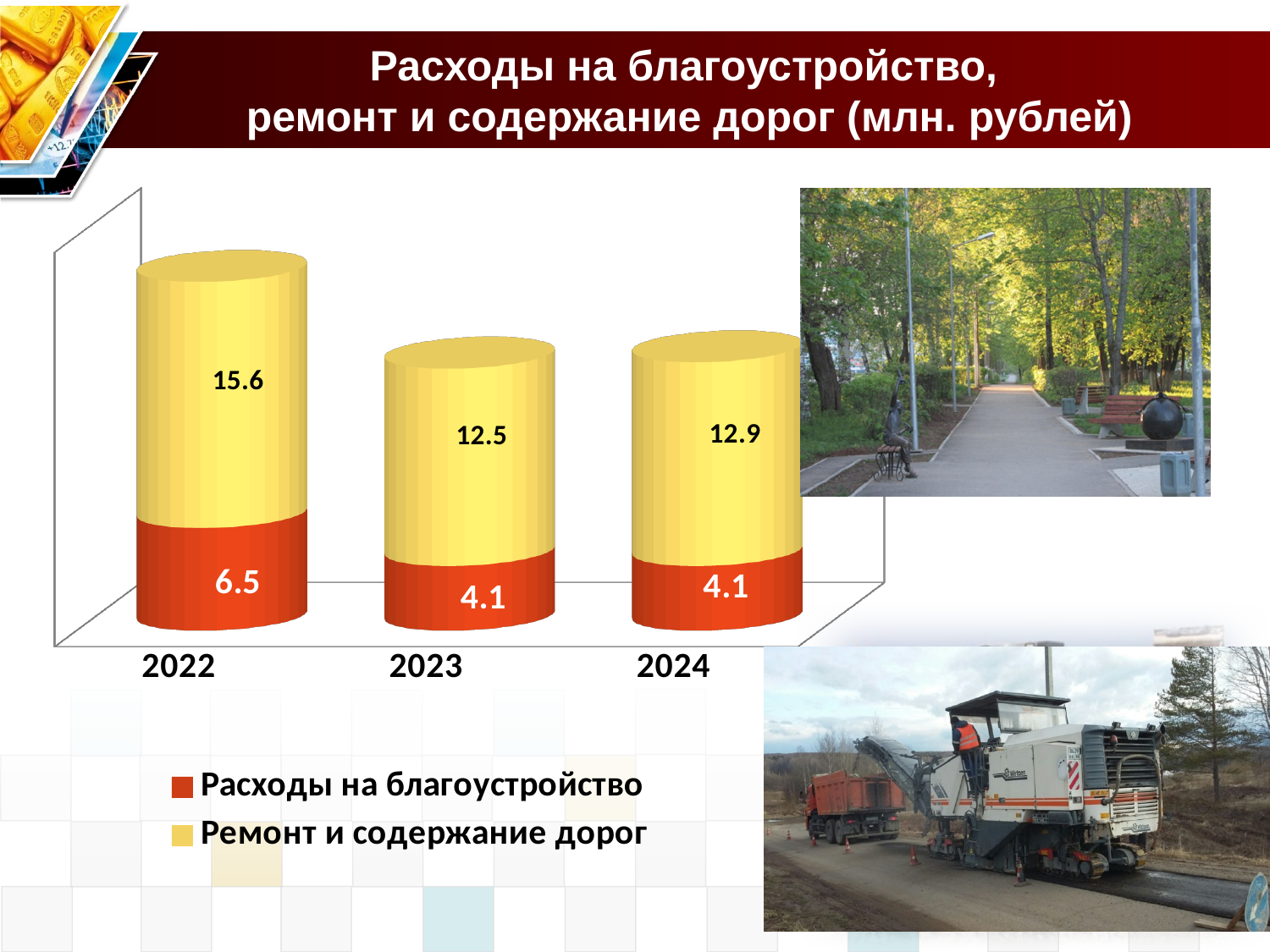
Which colour represents Расходы на благоустройство in the legend? Red What is the value for Расходы на благоустройство in 2023? 4.1 How many series does the legend list? 2 What is the value for Ремонт и содержание дорог in 2022? 15.6 What is the difference between Ремонт и содержание дорог in 2022 and 2023? 3.1 Which is larger: Расходы на благоустройство in 2022 or in 2024? 2022 What is the total of the stacked bar for 2022? 22.1 In which year is Ремонт и содержание дорог lowest? 2023 What is the value for Ремонт и содержание дорог in 2024? 12.9 What kind of chart is shown on the slide? Stacked bar chart In which year is Расходы на благоустройство highest? 2022 How many years are shown on the x axis? 3